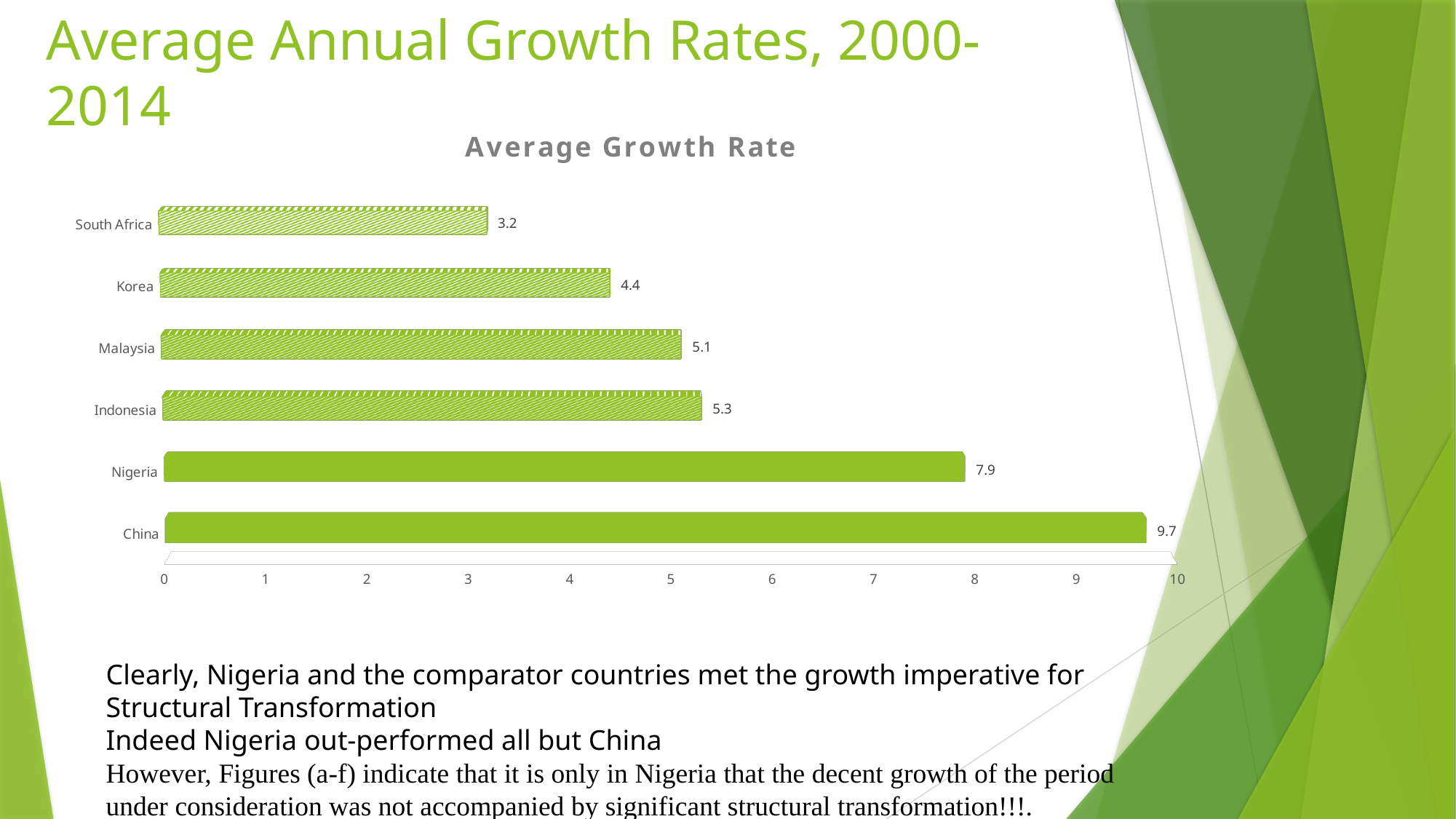
What type of chart is shown on the slide? Bar chart What is the average growth rate for China? 9.7 What is the average growth rate for Nigeria? 7.9 Which country has the highest average growth rate? China What is the average growth rate for South Africa? 3.2 What is the difference between Indonesia's and Malaysia's average growth rates? 0.2 How many countries are shown in the chart? 6 Which country has the lowest average growth rate? South Africa What is the average growth rate for Korea? 4.4 Which has a higher average growth rate, Korea or Malaysia? Malaysia What is the title of the chart? Average Growth Rate What is the difference between China's and Nigeria's average growth rates? 1.8